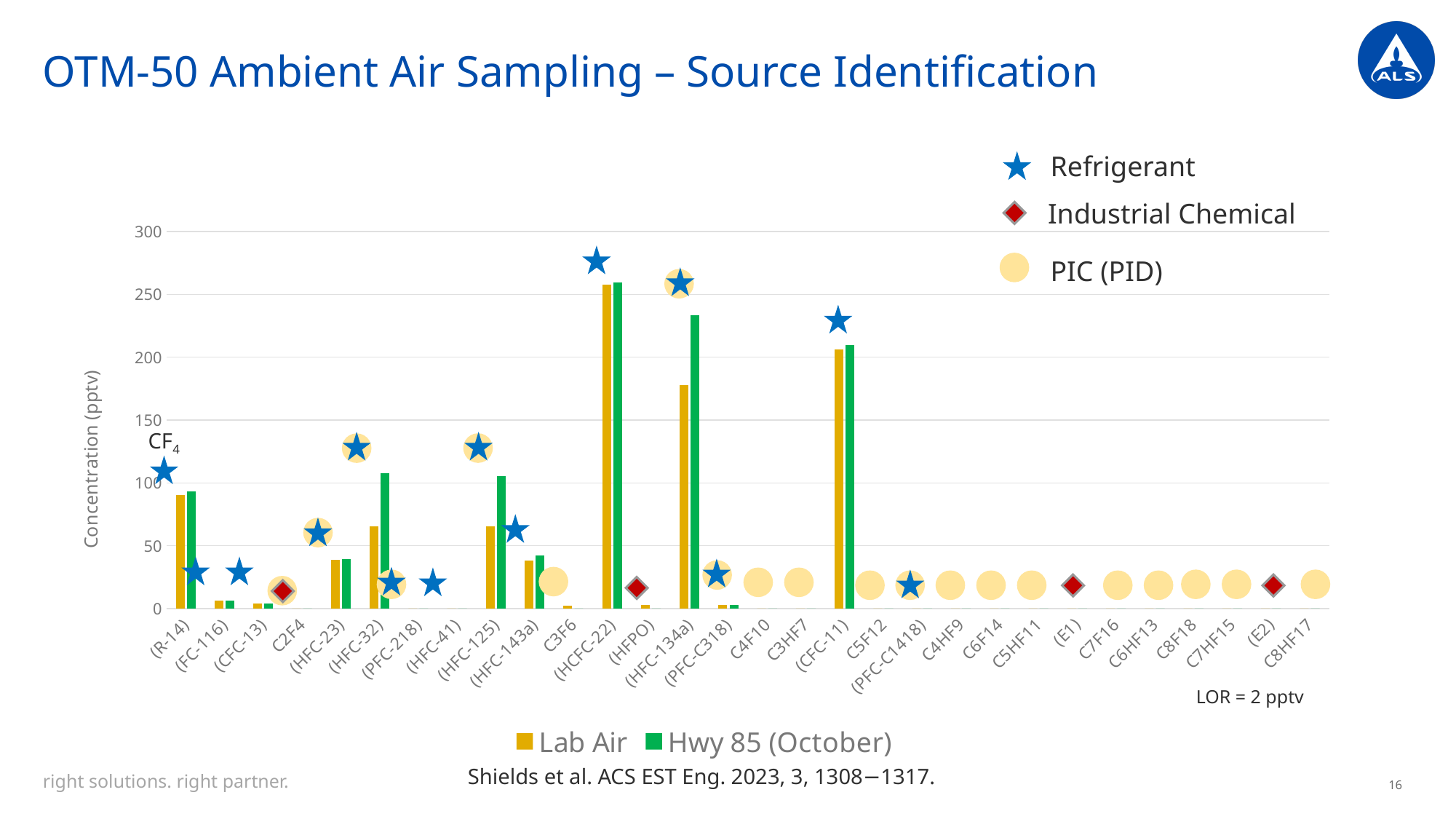
Which compound has the highest Hwy 85 (October) concentration? (HCFC-22) Which compound has the highest Lab Air concentration? (HCFC-22) Is the Lab Air value for (R-14) greater or less than 100? less Is the Hwy 85 (October) value for (HFC-32) greater or less than 50? greater What limit of reporting (LOR) is stated on the slide? LOR = 2 pptv What kind of chart is shown on the slide? bar chart How many series does the chart legend list? 2 For (HFC-32), which series has the larger value, Lab Air or Hwy 85 (October)? Hwy 85 (October) For (HFC-134a), which series has the larger value, Lab Air or Hwy 85 (October)? Hwy 85 (October) Is the Hwy 85 (October) value for (HFC-134a) greater or less than 200? greater What is the label of the vertical axis? Concentration (pptv)